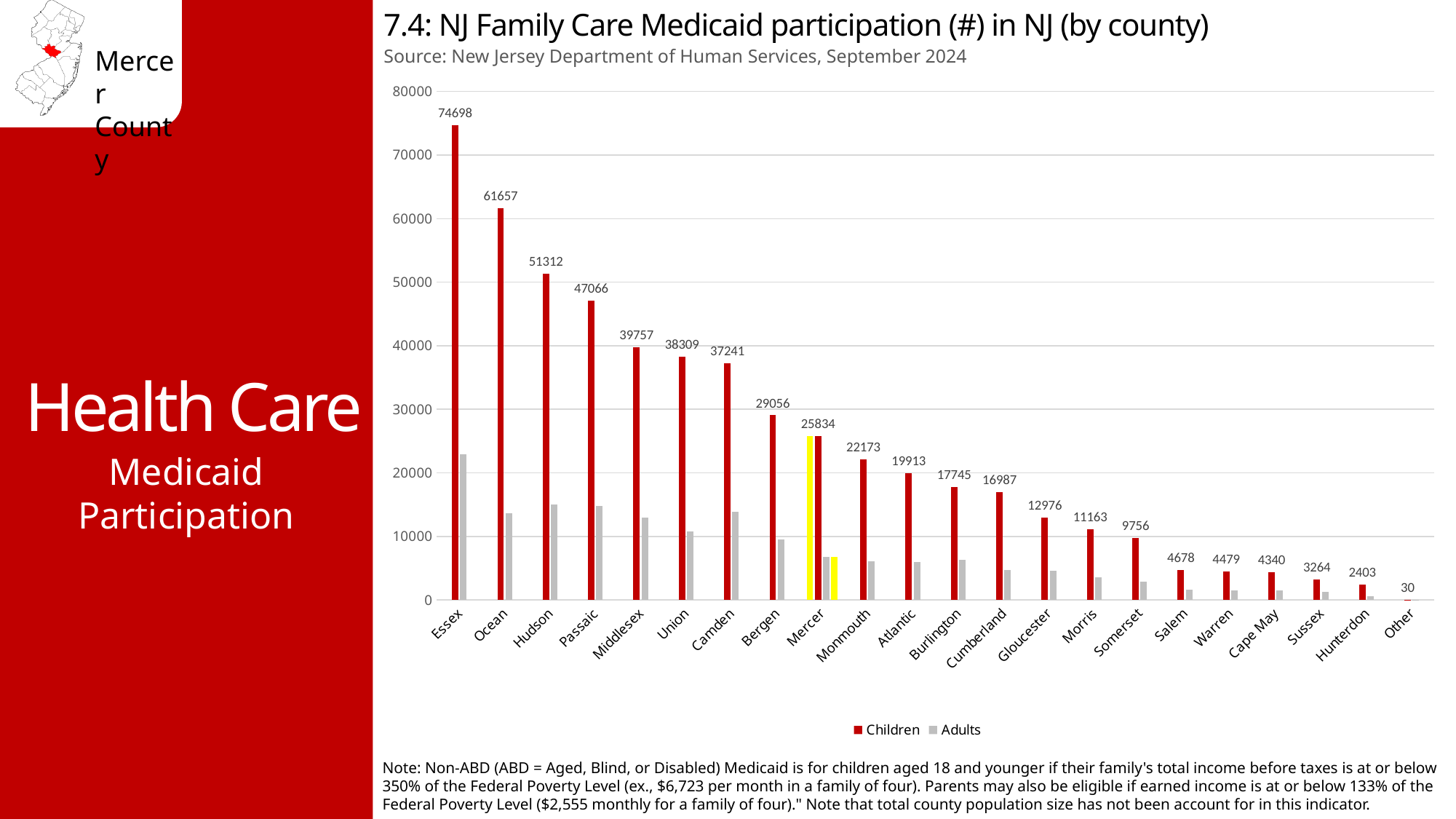
Do the Children values rise or fall moving from left to right along the x axis? fall What is the Children value for Essex? 74698 What kind of chart is shown on the slide? bar chart What is the Children value for Mercer? 25834 What is the difference between the Children values for Ocean and Hudson? 10345 Which county has the highest Children value? Essex Which has a larger Children value, Bergen or Monmouth? Bergen How many series does the legend list? 2 How many categories are shown on the x axis? 22 Which category has the lowest Children value? Other Is the Adults value for Essex greater or less than 20000? greater What is the Children value for Somerset? 9756